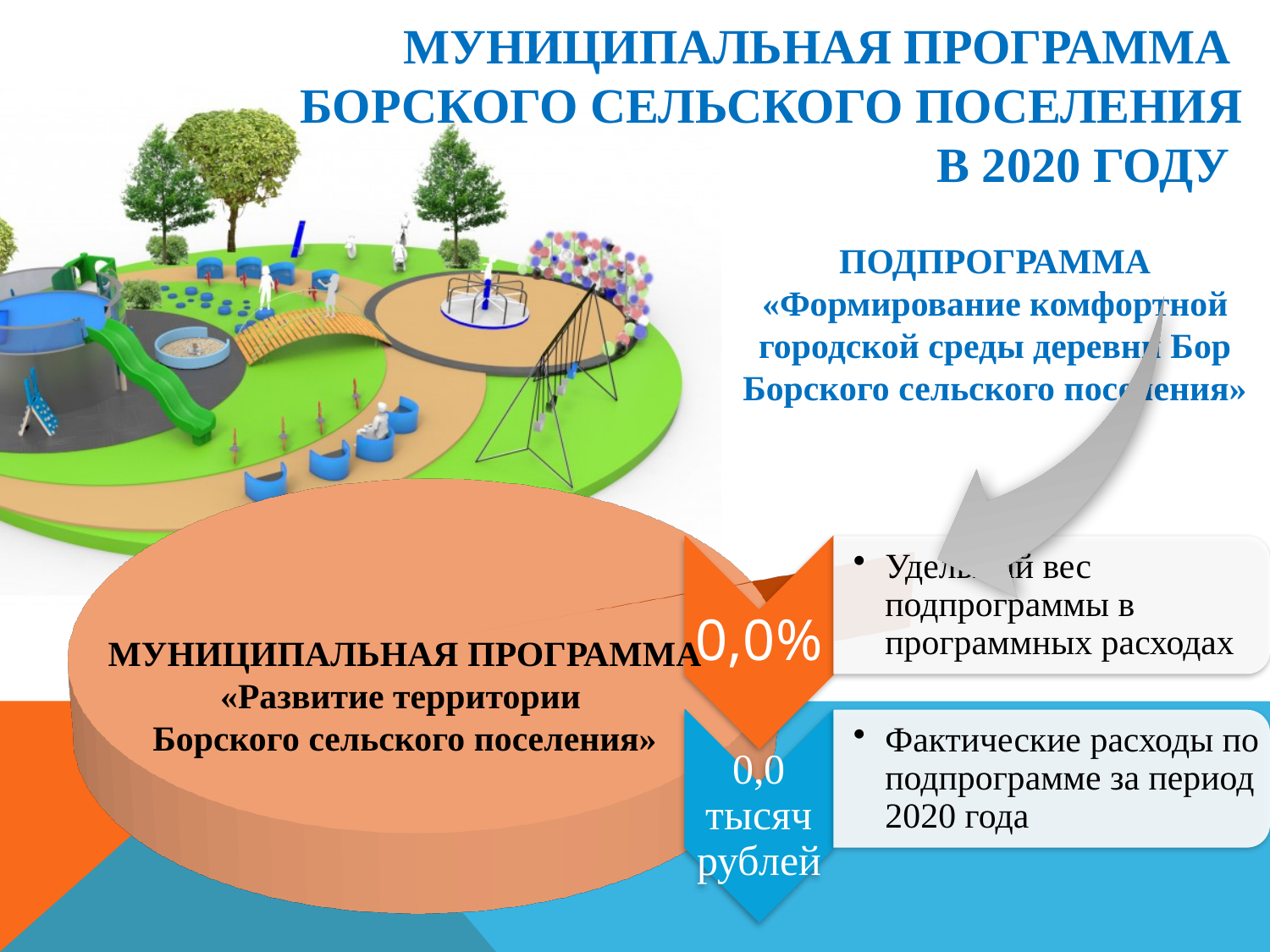
Which municipal programme is named on the pie chart? «Развитие территории Борского сельского поселения» What share of the pie chart is labelled for the subprogram «Формирование комфортной городской среды деревни Бор Борского сельского поселения»? 0,0% Does the pie chart show a legend? No What colour is the large slice of the pie chart? orange What kind of chart is shown on the slide? pie chart How many visible slices does the pie chart have? 1